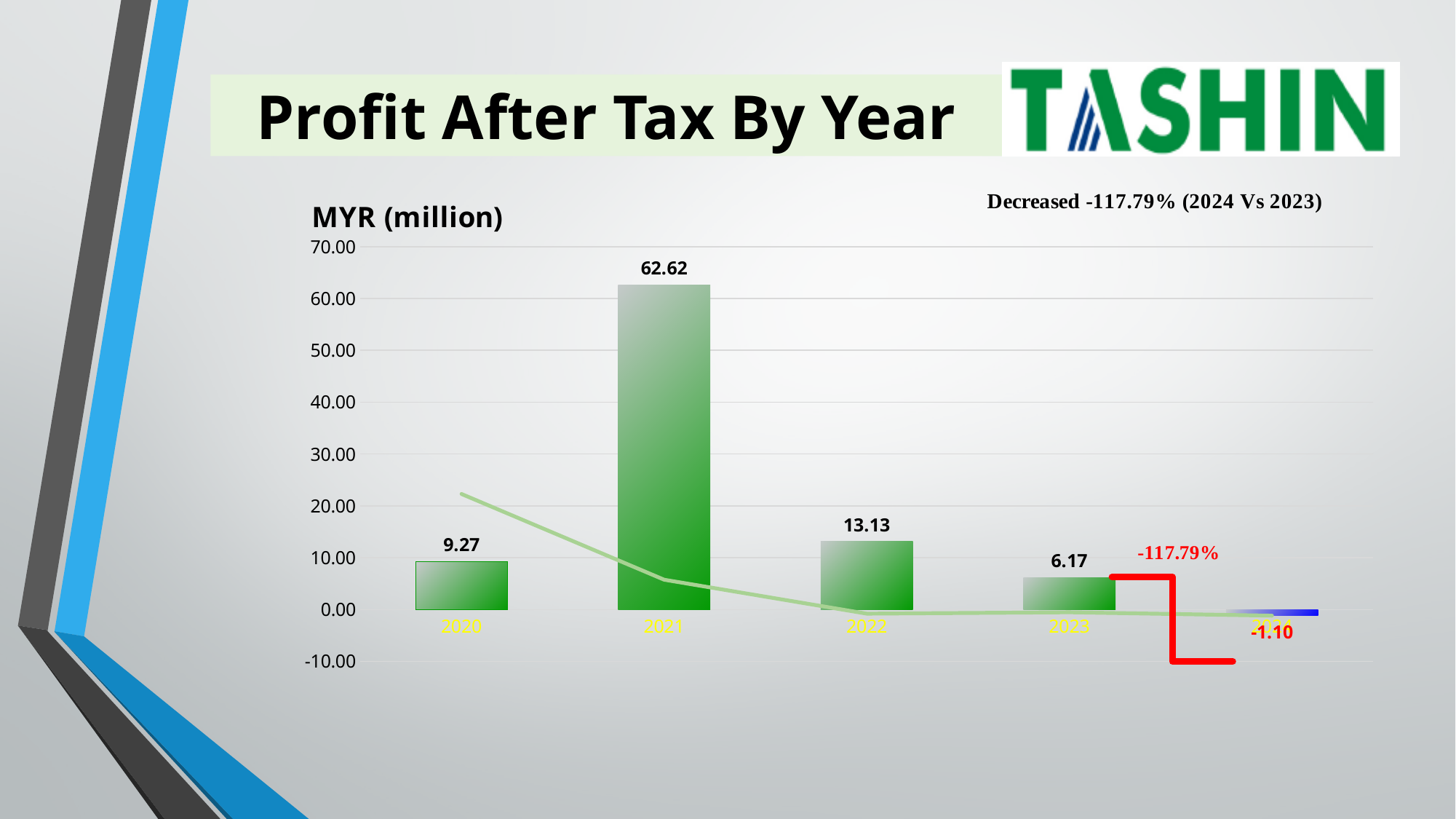
What is the profit after tax for 2021? 62.62 How many years are shown on the x axis of the chart? 5 What is the profit after tax for 2020? 9.27 Which year has the lowest profit after tax? 2024 Which year has a larger profit after tax, 2020 or 2022? 2022 Is the value for 2021 greater or less than 60.00? greater What is the difference between the profit after tax in 2022 and 2023? 6.96 What is the profit after tax for 2024? -1.10 Which year has the highest profit after tax? 2021 What percentage change is annotated for 2024 vs 2023? -117.79% What kind of chart is used to show profit after tax by year? bar chart What is the unit shown on the y axis of the chart? MYR (million)